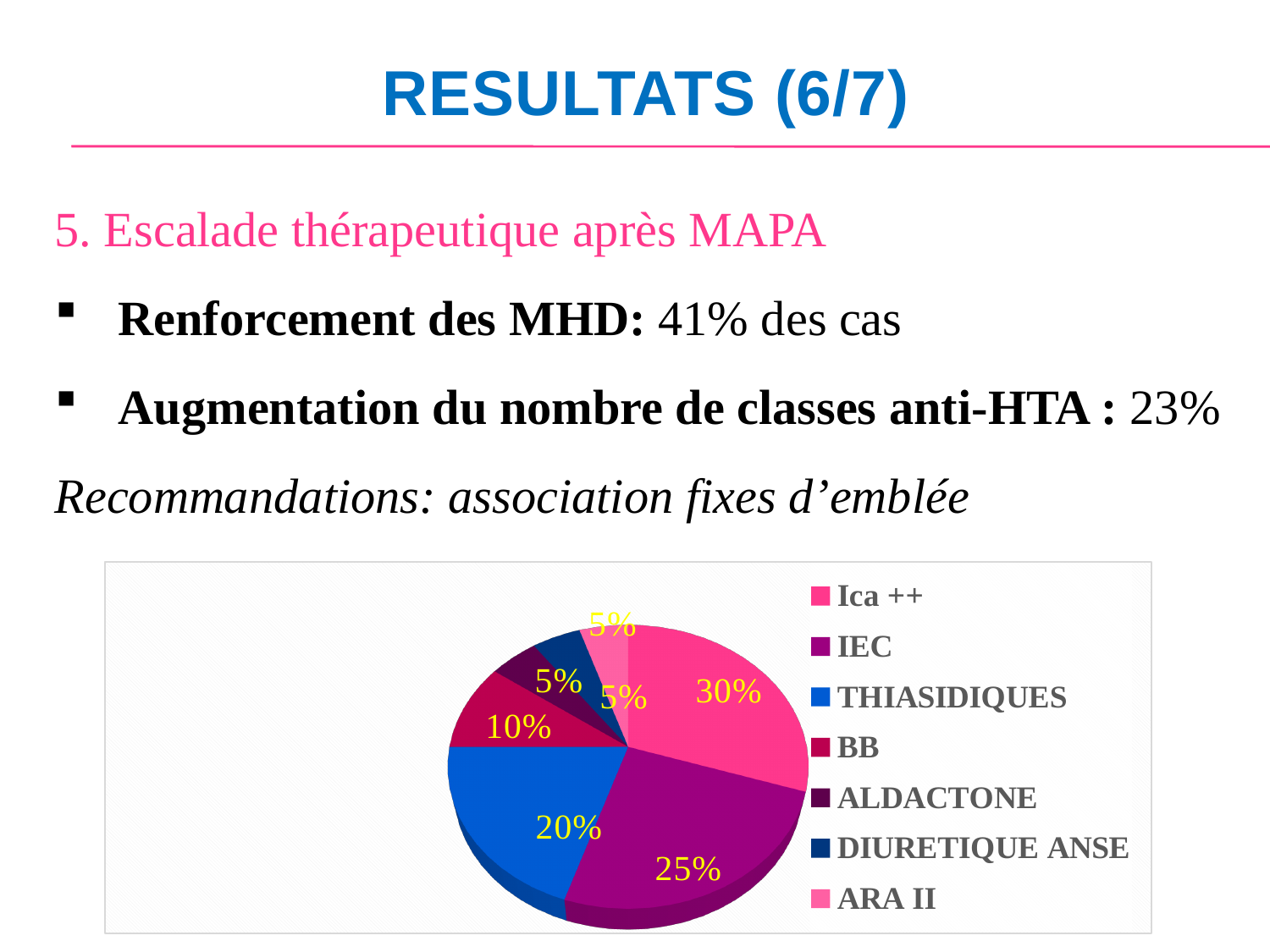
How many categories does the pie chart contain? 7 Which category has the largest slice of the pie? Ica ++ What is the value shown for THIASIDIQUES? 20% What type of chart is shown on the slide? pie chart Which is larger, the value for IEC or the value for THIASIDIQUES? IEC What is the difference between the values for Ica ++ and IEC? 5% What is the difference between the values for THIASIDIQUES and BB? 10% Which legend entry is shown in blue? THIASIDIQUES What is the value shown for ARA II? 5% What share of the pie does Ica ++ represent? 30% What is the value shown for IEC? 25% What is the value shown for BB? 10%